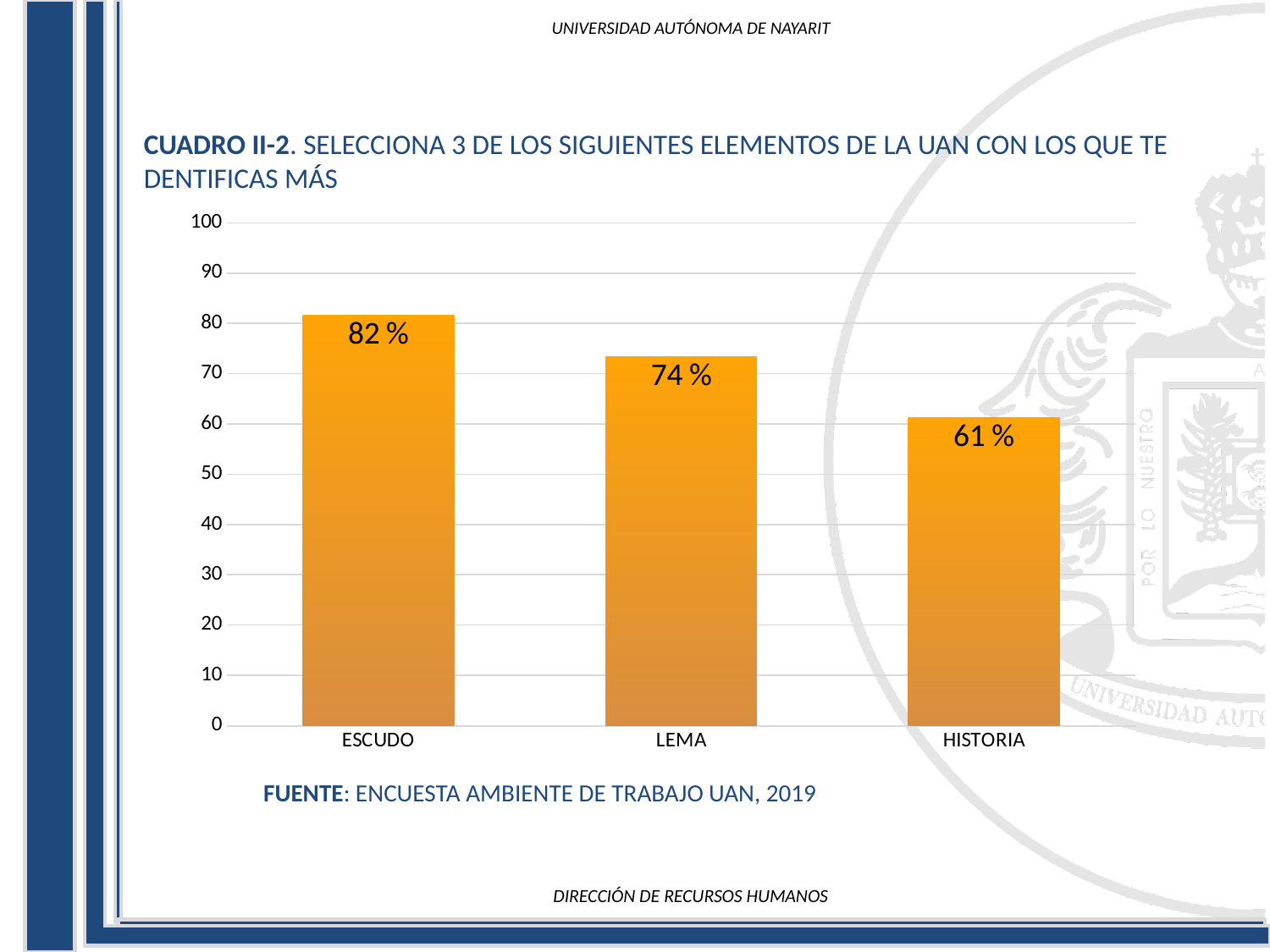
What is the value for LEMA? 74 % What is the difference between the values for ESCUDO and LEMA? 8 % What is the value for ESCUDO? 82 % What is the difference between the values for ESCUDO and HISTORIA? 21 % Is the value for HISTORIA greater or less than 70? less What is the value for HISTORIA? 61 % How many categories are shown on the x axis? 3 Which category has the highest value? ESCUDO Do the values rise or fall from left to right along the x axis? fall Which category has the lowest value? HISTORIA Which is larger, the value for LEMA or the value for HISTORIA? LEMA What kind of chart is shown on the slide? bar chart